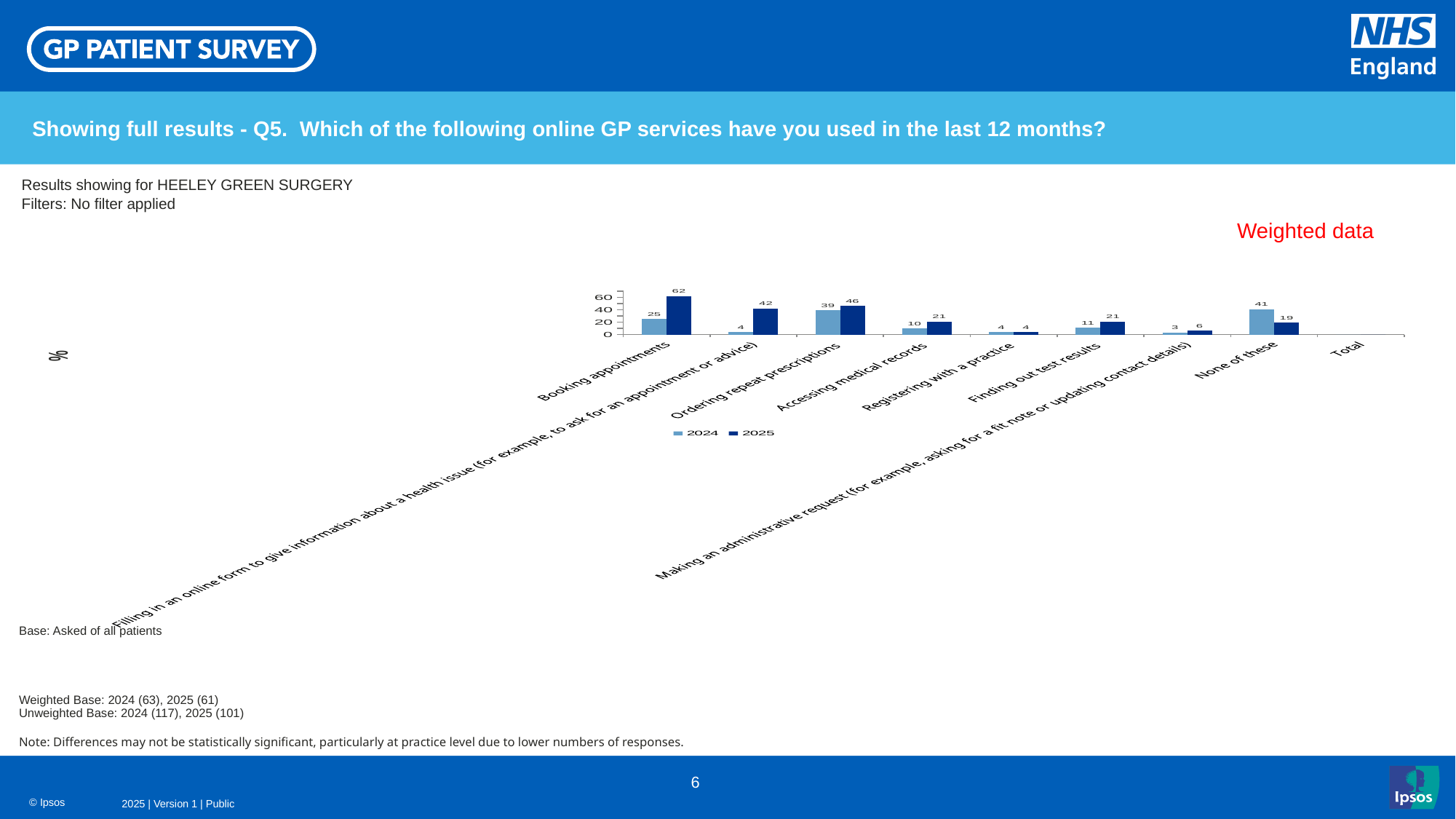
Which is larger for None of these, the 2024 value or the 2025 value? 2024 What kind of chart is shown on the slide? Bar chart What is the 2025 value for Booking appointments? 62 Which category has the lowest 2024 value? Making an administrative request (for example, asking for a fit note or updating contact details) What is the difference between the 2025 and 2024 values for Booking appointments? 37 Is the 2025 value for Ordering repeat prescriptions greater or less than 40? greater What is the 2024 value for Ordering repeat prescriptions? 39 How many series does the legend list? 2 What is the 2025 value for Finding out test results? 21 What is the 2024 value for None of these? 41 What is the 2025 value for Registering with a practice? 4 Which category has the highest 2025 value? Booking appointments